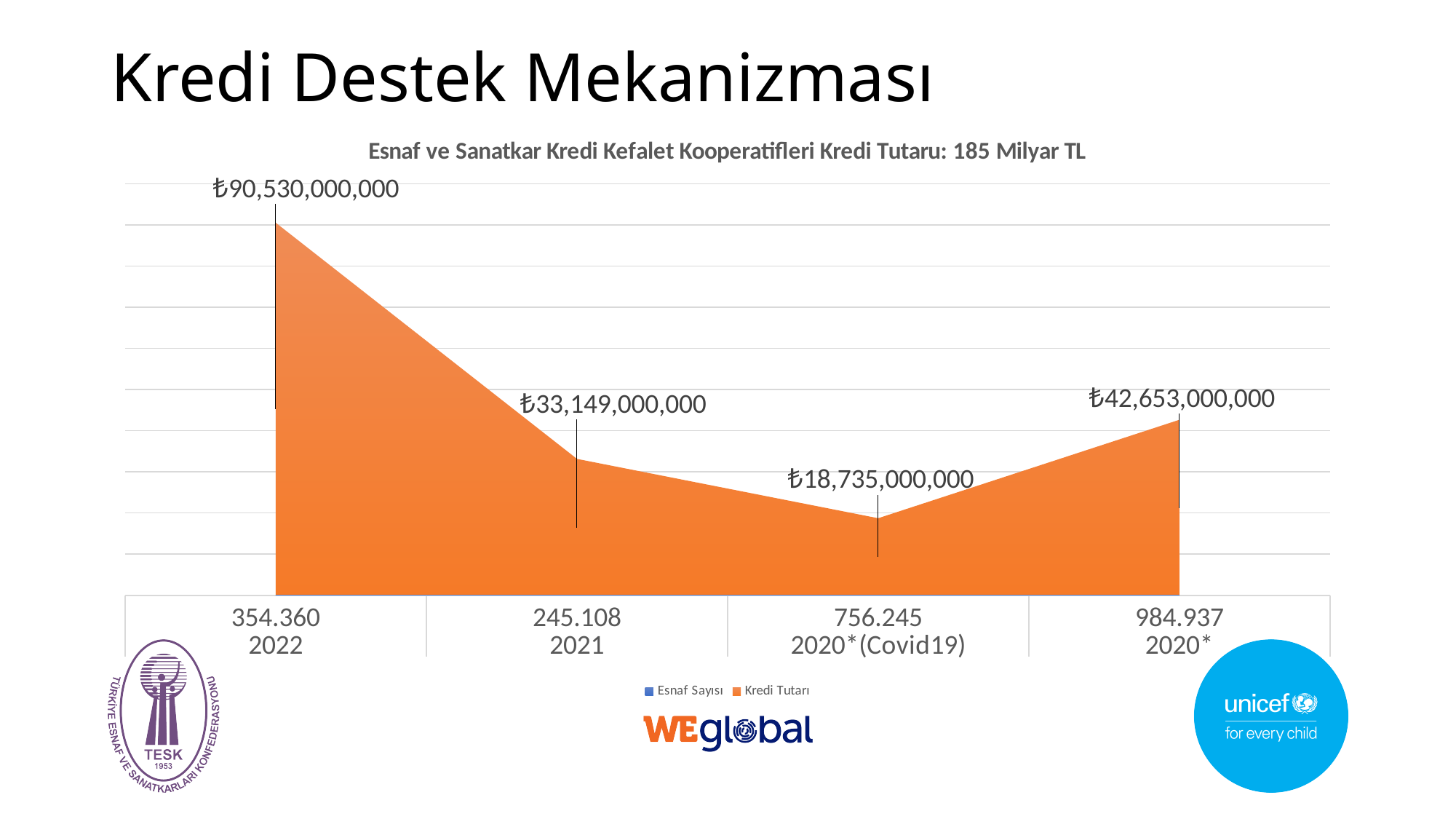
How many categories are shown on the x axis? 4 What is the Kredi Tutarı value for 2020* (984.937)? ₺42,653,000,000 How many series does the legend list? 2 Which category has the highest Kredi Tutarı? 2022 What is the Kredi Tutarı value for 2022 (354.360)? ₺90,530,000,000 What is the difference between the Kredi Tutarı for 2022 and for 2021? ₺57,381,000,000 Which category has the lowest Kredi Tutarı? 2020*(Covid19) What is the title of the chart? Esnaf ve Sanatkar Kredi Kefalet Kooperatifleri Kredi Tutaru: 185 Milyar TL What is the Kredi Tutarı value for 2021 (245.108)? ₺33,149,000,000 What is the difference between the Kredi Tutarı for 2020* and for 2020*(Covid19)? ₺23,918,000,000 Which is larger, the Kredi Tutarı for 2021 or for 2020*? 2020* What is the Kredi Tutarı value for 2020*(Covid19)? ₺18,735,000,000